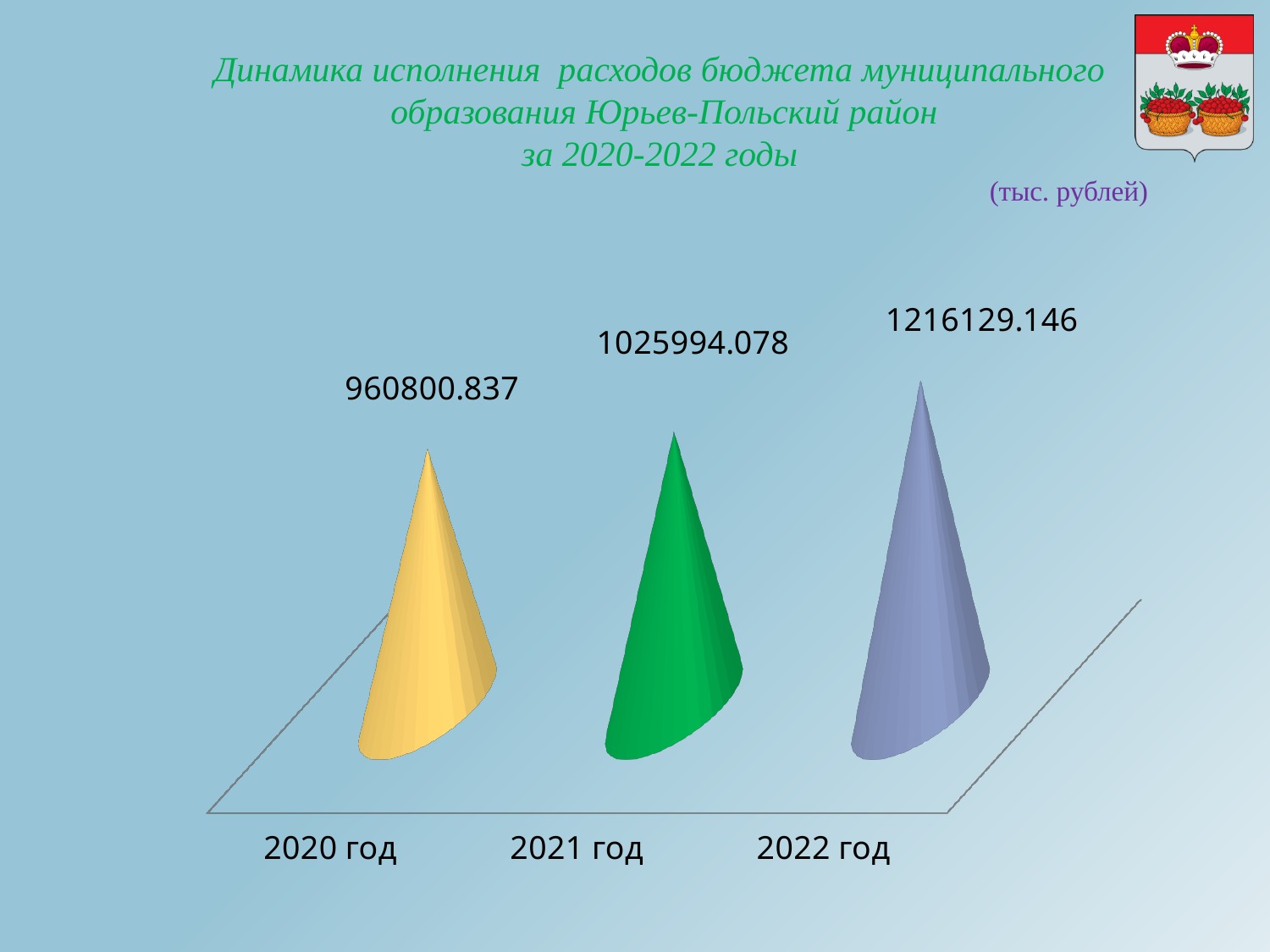
Do the values rise or fall from 2020 год to 2022 год? rise Which year has the highest value? 2022 год In what units are the chart values given? тыс. рублей What is the value for 2020 год? 960800.837 What is the difference between the values for 2022 год and 2021 год? 190135.068 What is the value for 2021 год? 1025994.078 Which is larger, the value for 2021 год or the value for 2022 год? 2022 год Which year has the lowest value? 2020 год What is the difference between the values for 2021 год and 2020 год? 65193.241 What is the value for 2022 год? 1216129.146 How many years are shown on the chart? 3 What is the difference between the values for 2022 год and 2020 год? 255328.309